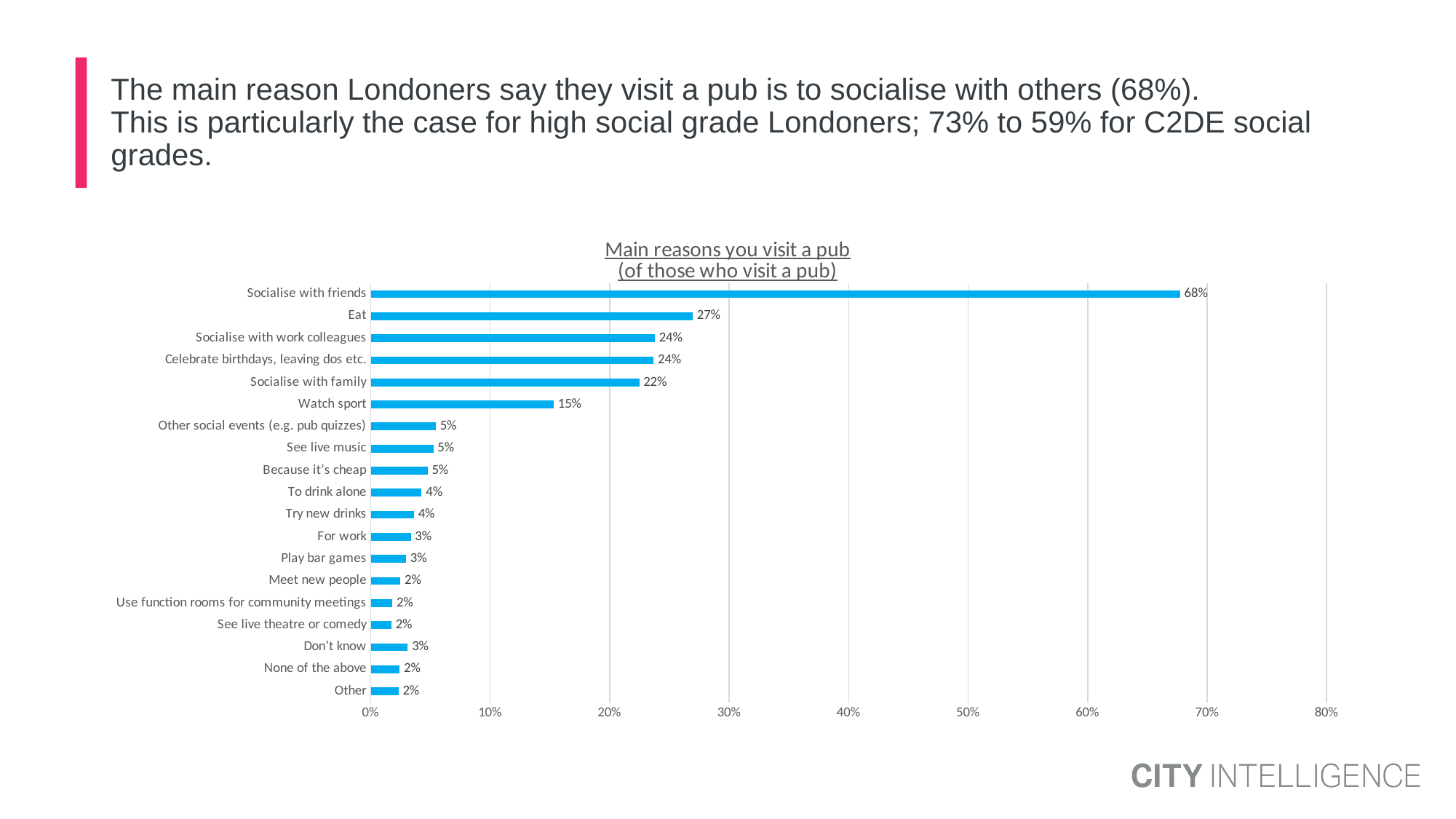
What is the difference between 'Socialise with friends' and 'Eat'? 41% What percentage visit a pub to watch sport? 15% What percentage of respondents say they visit a pub to socialise with friends? 68% What is the value for 'Socialise with family'? 22% What kind of chart is shown on the slide? Bar chart Which is larger, the value for 'Eat' or the value for 'Socialise with work colleagues'? Eat What is the title of the chart? Main reasons you visit a pub (of those who visit a pub) What is the difference between 'Socialise with family' and 'Watch sport'? 7% What is the value for 'Eat'? 27% Which reason for visiting a pub has the highest percentage? Socialise with friends Is the value for 'Socialise with friends' greater or less than 60%? greater How many reasons (categories) are listed in the chart? 19